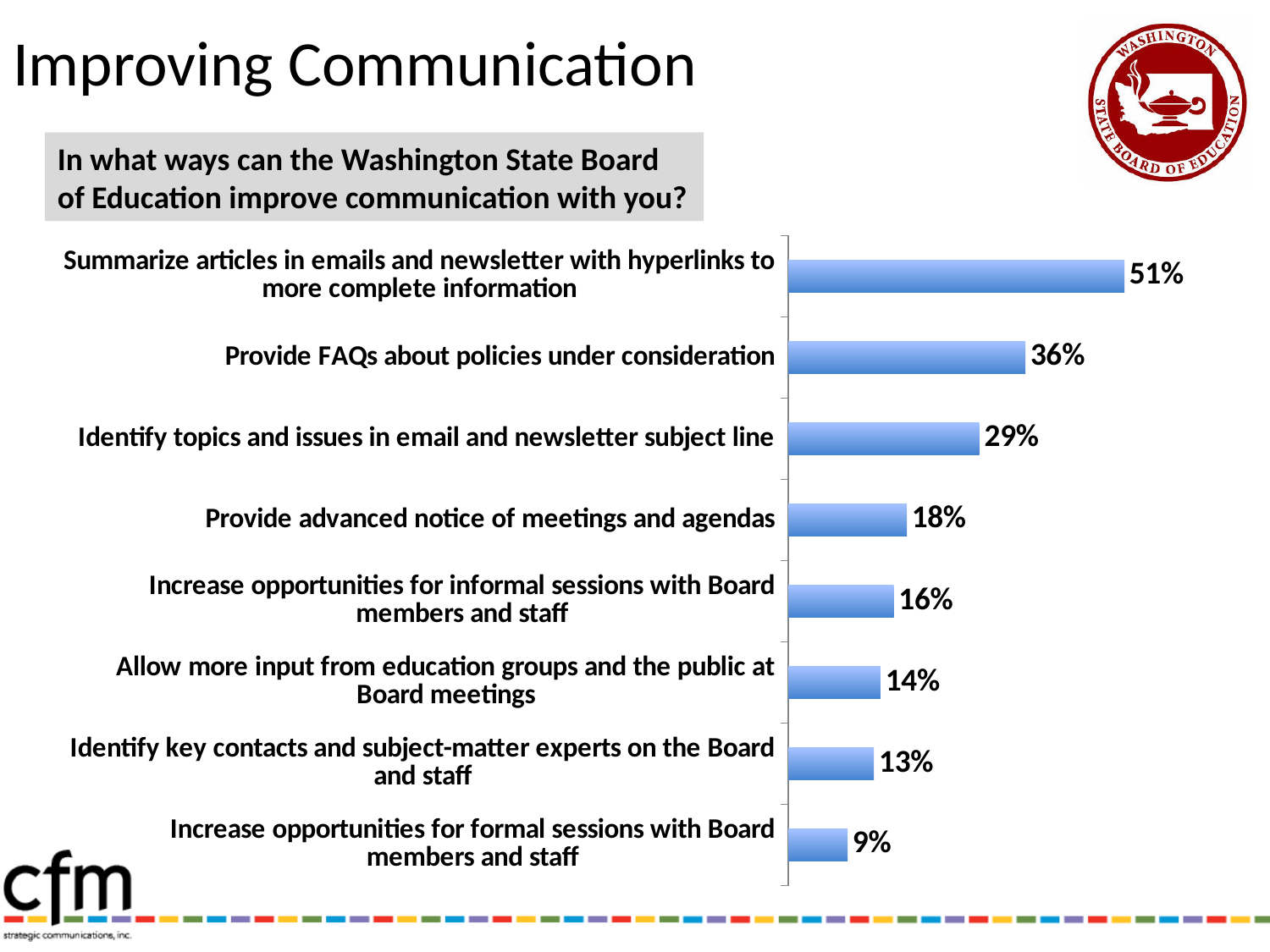
How many categories are shown in the chart? 8 What is the value for "Provide advanced notice of meetings and agendas"? 18% Do the values increase or decrease going from the top bar to the bottom bar? Decrease What survey question does the chart answer? In what ways can the Washington State Board of Education improve communication with you? Which is larger: the value for "Increase opportunities for informal sessions with Board members and staff" or for "Allow more input from education groups and the public at Board meetings"? Increase opportunities for informal sessions with Board members and staff Which category has the lowest value? Increase opportunities for formal sessions with Board members and staff What is the value for "Identify key contacts and subject-matter experts on the Board and staff"? 13% What is the difference between the values for "Summarize articles in emails and newsletter with hyperlinks to more complete information" and "Provide FAQs about policies under consideration"? 15% What percentage of respondents chose "Provide FAQs about policies under consideration"? 36% Which category has the highest value? Summarize articles in emails and newsletter with hyperlinks to more complete information What kind of chart is shown on the slide? Bar chart What is the difference between the values for "Identify topics and issues in email and newsletter subject line" and "Provide advanced notice of meetings and agendas"? 11%